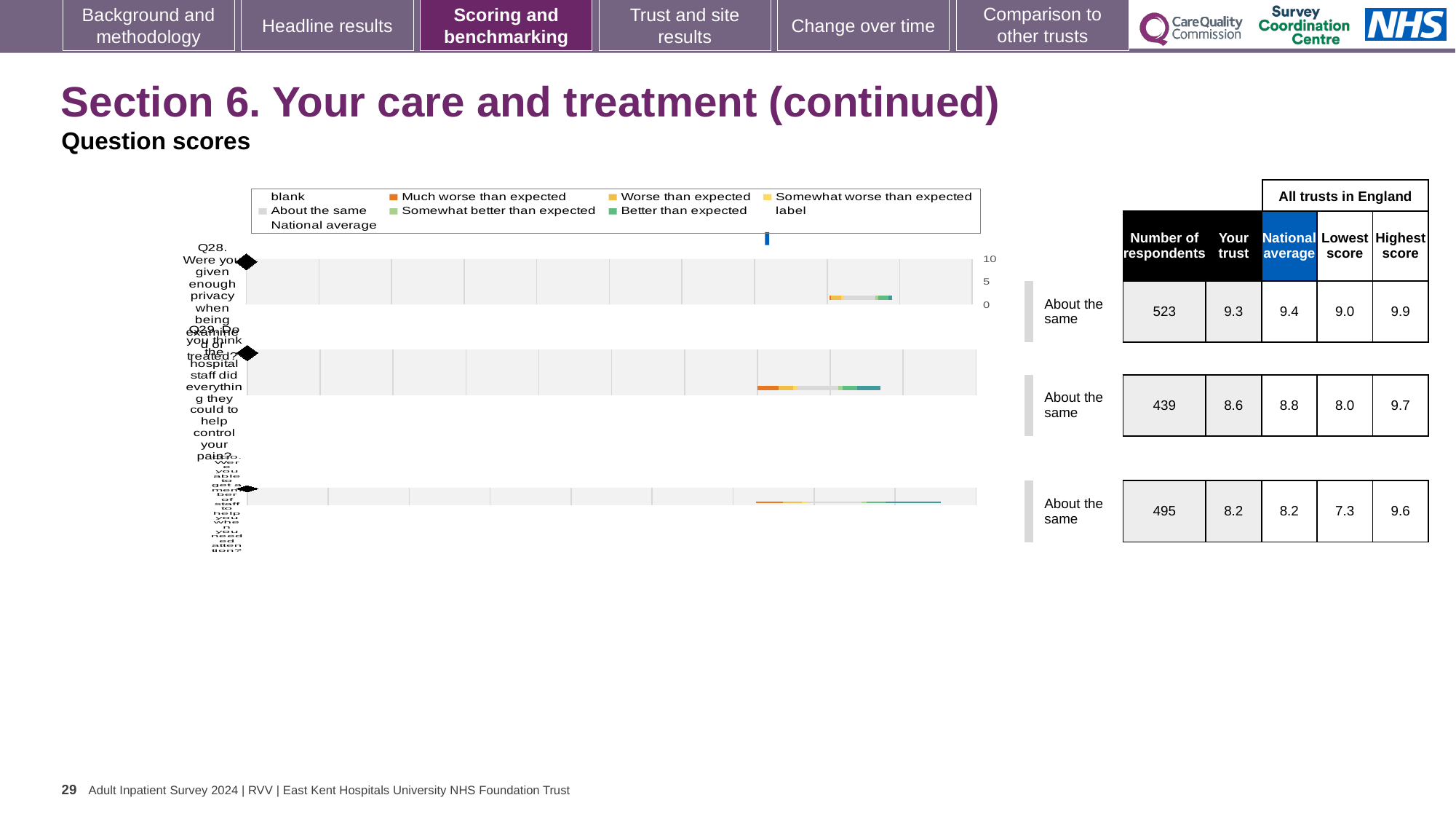
What is the difference between the highest score and the lowest score across all trusts in England for Q28? 0.9 What kind of chart is shown on the slide? bar chart Which question has the lowest number of respondents? Q29 How many respondents answered Q29? 439 For Q28, which is larger: the 'Your trust' score or the national average? National average What benchmark category is shown for Q29? About the same What is the 'Your trust' score for Q29 (hospital staff did everything to help control your pain)? 8.6 How many questions (rows) are plotted in the chart? 3 What is the 'Your trust' score for Q28 (privacy when being examined or treated)? 9.3 Which question has the highest 'Your trust' score? Q28 What is the maximum value shown on the chart's score axis? 10 What is the national average score for Q28? 9.4